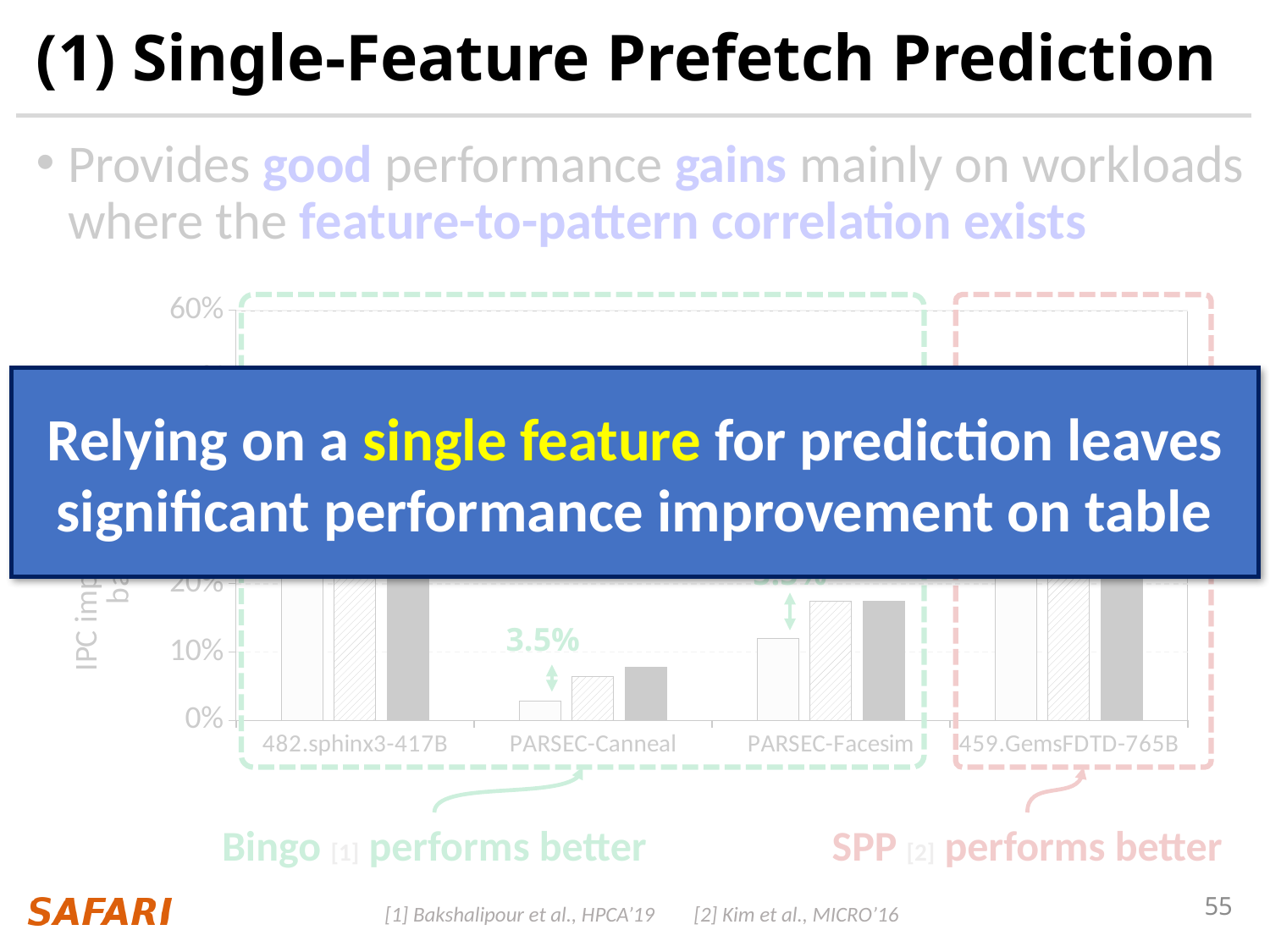
What percentage value is annotated above the bars for PARSEC-Canneal? 3.5% Which workload category has the lowest bars in the chart? PARSEC-Canneal Which has the larger leftmost (white) bar: PARSEC-Canneal or PARSEC-Facesim? PARSEC-Facesim Is the value of the rightmost (gray) bar for PARSEC-Facesim greater or less than 20%? less How many bars are plotted for each workload category in the chart? 3 Is the value of the leftmost (white) bar for PARSEC-Facesim greater or less than 10%? greater What kind of chart is shown on the slide? bar chart How many workload categories are shown on the x axis of the chart? 4 For PARSEC-Canneal, which is larger: the leftmost (white) bar or the rightmost (gray) bar? the rightmost (gray) bar Is the value of the leftmost (white) bar for PARSEC-Canneal greater or less than 10%? less Which workload category is enclosed in the red dashed box labelled 'SPP performs better'? 459.GemsFDTD-765B